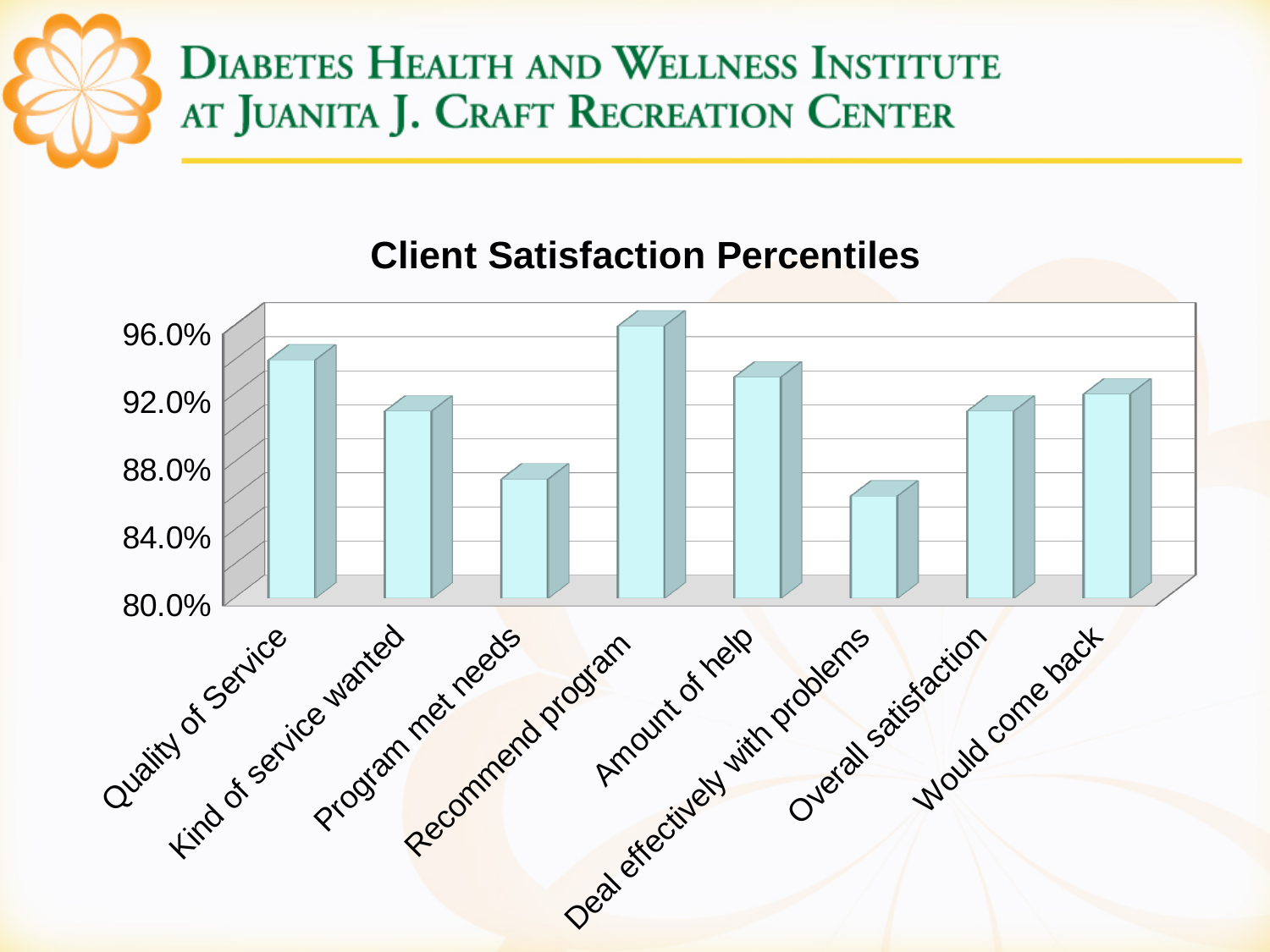
Is the value for Quality of Service greater or less than 92.0%? greater Is the value for Recommend program greater or less than 92.0%? greater Is the value for Program met needs greater or less than 88.0%? less What is the title of the chart? Client Satisfaction Percentiles Which is larger, the value for Recommend program or the value for Deal effectively with problems? Recommend program What kind of chart is shown on the slide? bar chart Which category has the highest value in the chart? Recommend program How many categories are plotted in the chart? 8 Which is larger, the value for Amount of help or the value for Program met needs? Amount of help Which is larger, the value for Quality of Service or the value for Kind of service wanted? Quality of Service